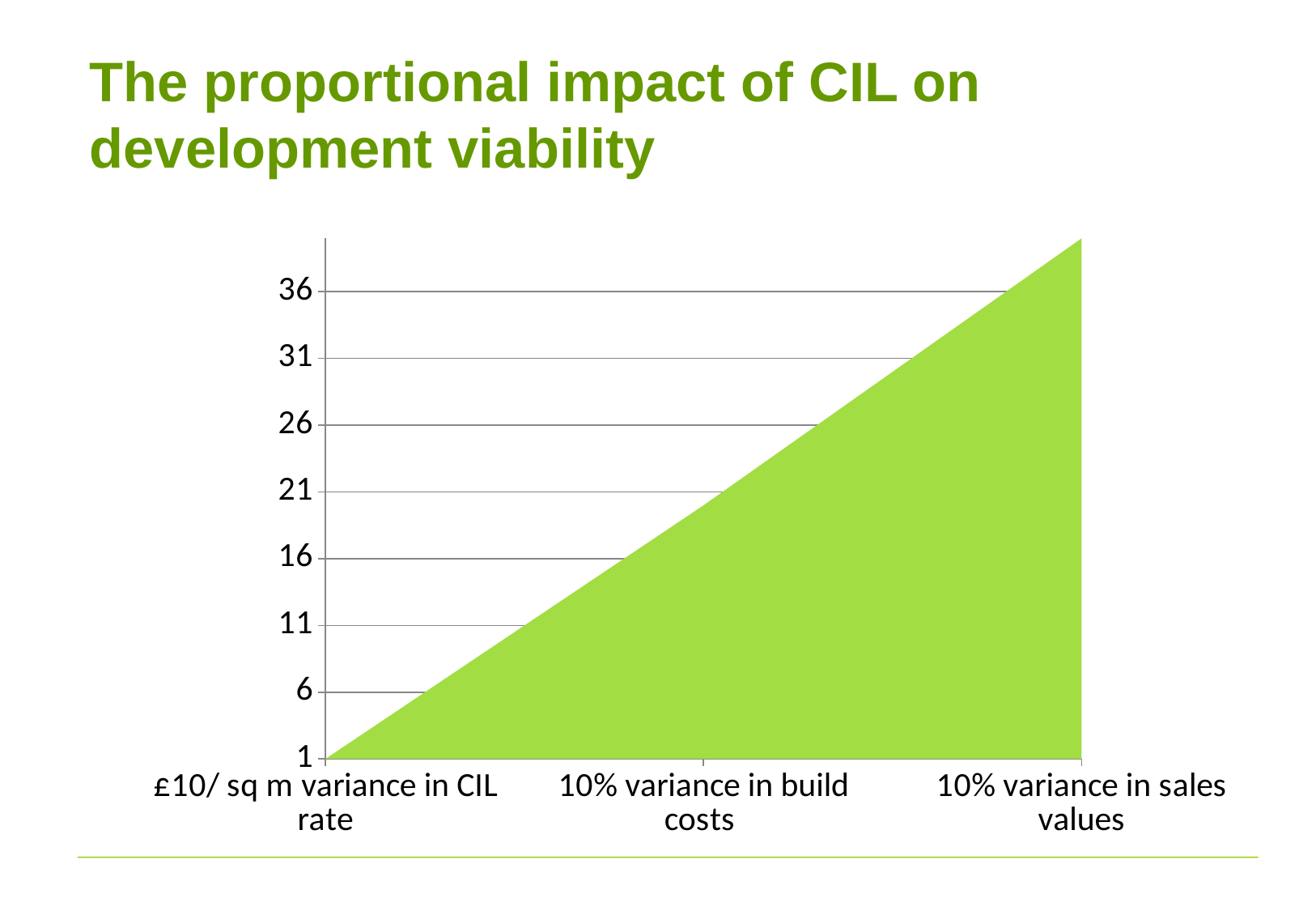
Is the value for 10% variance in build costs greater or less than 26? less How many categories are shown on the x axis of the chart? 3 What is the value for £10/ sq m variance in CIL rate? 1 Which category has the highest value? 10% variance in sales values Do the values rise or fall moving from left to right along the x axis? Rise What is the title of the slide containing the chart? The proportional impact of CIL on development viability What colour is the shaded area in the chart? Green Is the value for 10% variance in build costs greater or less than 16? greater Is the value for 10% variance in sales values greater or less than 36? greater Which is larger, the value for 10% variance in build costs or the value for 10% variance in sales values? 10% variance in sales values What kind of chart is shown on the slide? Area chart Which category has the lowest value? £10/ sq m variance in CIL rate